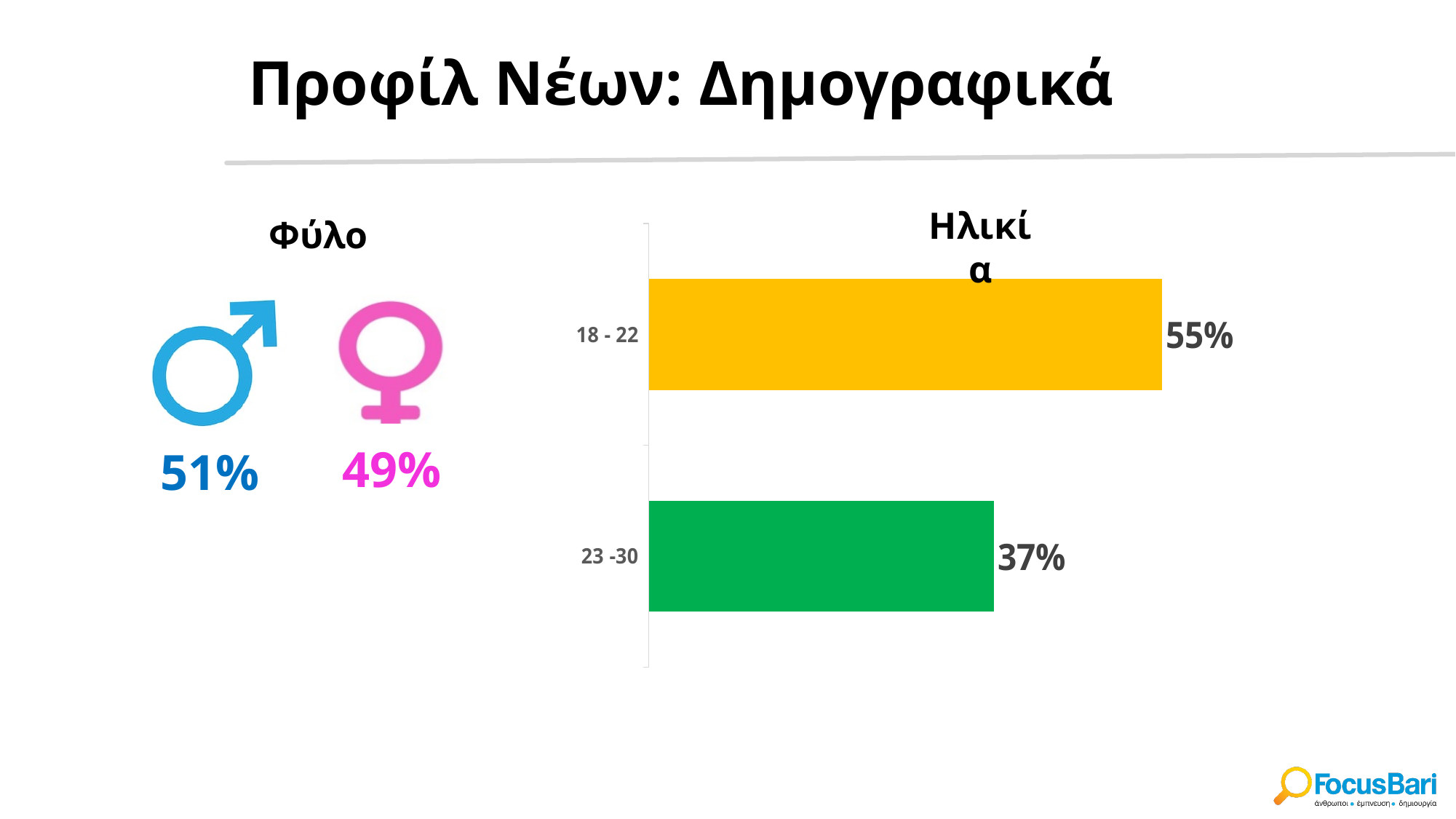
In the Ηλικία chart, what is the value for the 23 -30 age group? 37% What is the title of the bar chart on the right side of the slide? Ηλικία In the Φύλο section, what percentage is shown next to the male symbol? 51% How many age groups are shown in the Ηλικία chart? 2 In the Ηλικία chart, which age group has the highest value? 18 - 22 In the Ηλικία chart, what is the value for the 18 - 22 age group? 55% In the Ηλικία chart, which is larger: the value for 18 - 22 or the value for 23 -30? 18 - 22 What kind of chart is the Ηλικία chart? Bar chart In the Ηλικία chart, which age group has the lowest value? 23 -30 In the Φύλο section, what percentage is shown next to the female symbol? 49% In the Ηλικία chart, what is the difference between the values for 18 - 22 and 23 -30? 18% In the Ηλικία chart, what colour is the bar for the 23 -30 age group? Green